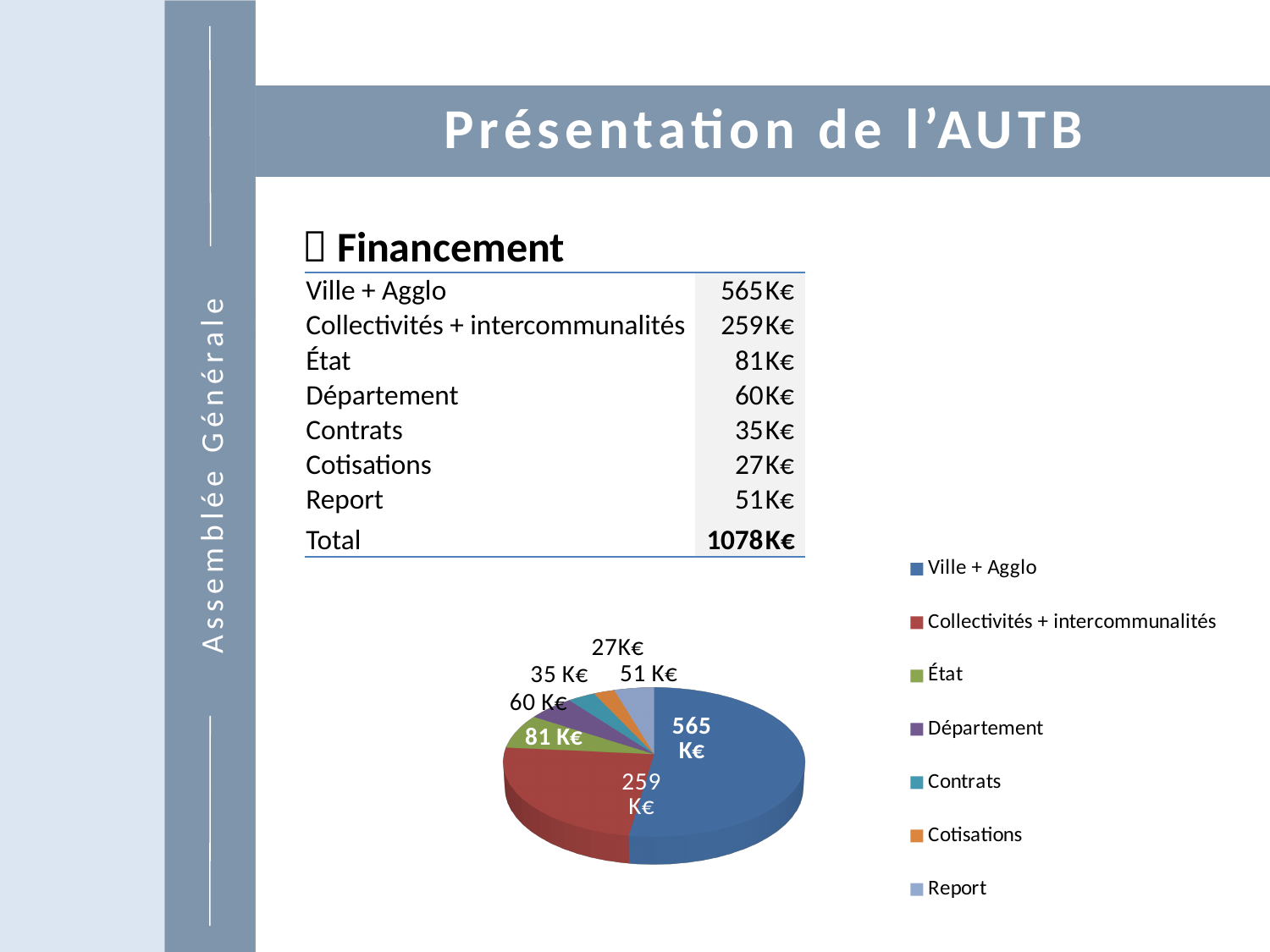
Which is larger in the pie chart: Département or Contrats? Département In the pie chart, what is the value for Report? 51 K€ In the pie chart, what is the value for Cotisations? 27K€ What kind of chart is shown on the slide? pie chart Which category has the smallest slice in the pie chart? Cotisations What is the difference between the Ville + Agglo value and the Collectivités + intercommunalités value in the pie chart? 306 K€ How many categories does the pie chart legend list? 7 Which category has the largest slice in the pie chart? Ville + Agglo In the pie chart, what is the value for Ville + Agglo? 565 K€ In the pie chart, what is the value for Collectivités + intercommunalités? 259 K€ What colour is the Ville + Agglo slice in the pie chart? blue In the pie chart, what is the value for État? 81 K€